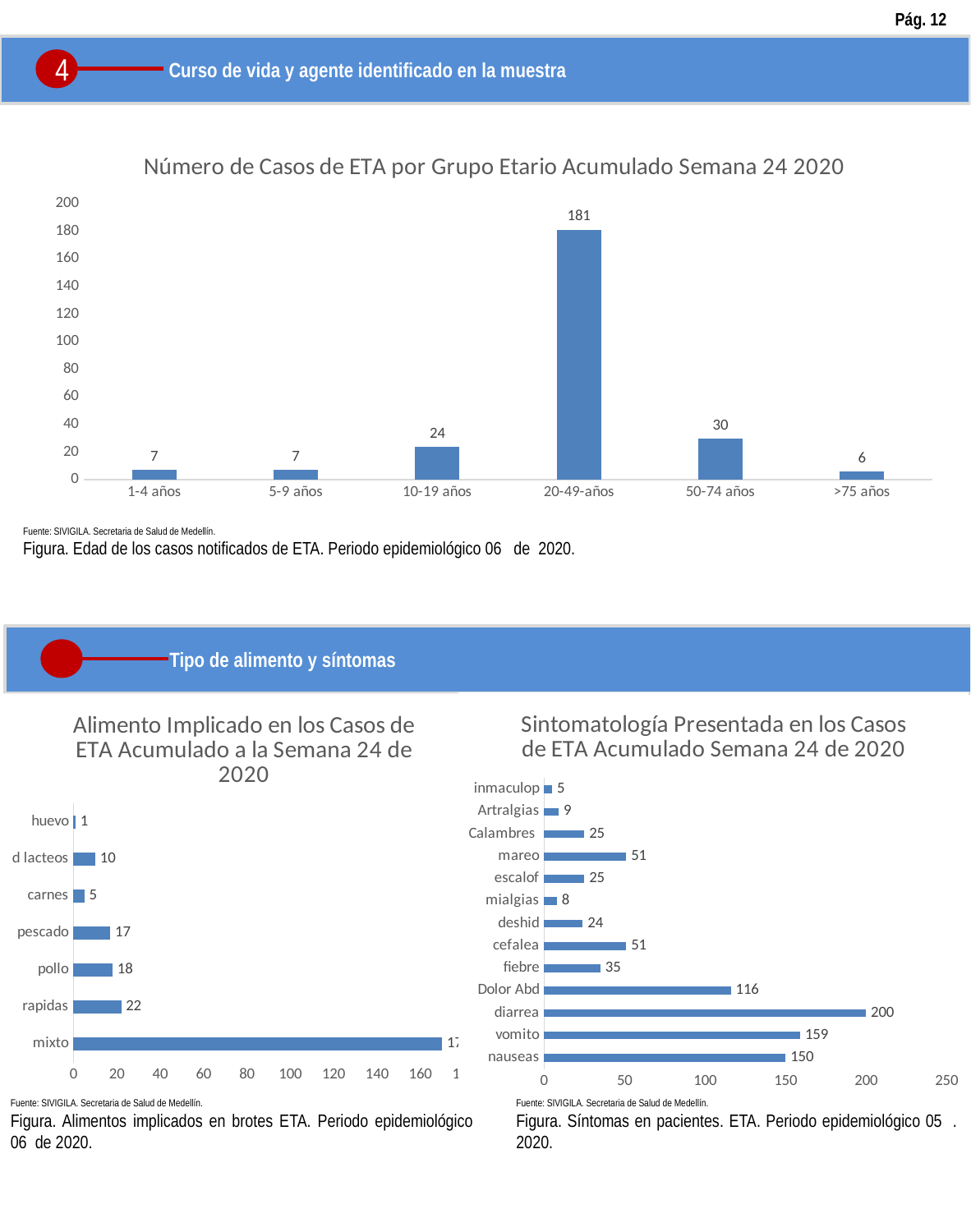
How many symptom categories are shown in the chart 'Sintomatología Presentada en los Casos de ETA Acumulado Semana 24 de 2020'? 13 In the chart 'Número de Casos de ETA por Grupo Etario Acumulado Semana 24 2020', which age group has the lowest value? >75 años In the chart 'Sintomatología Presentada en los Casos de ETA Acumulado Semana 24 de 2020', what is the difference between the values for diarrea and Dolor Abd? 84 In the chart 'Alimento Implicado en los Casos de ETA Acumulado a la Semana 24 de 2020', which category has the highest value? mixto In the chart 'Alimento Implicado en los Casos de ETA Acumulado a la Semana 24 de 2020', is the value for mixto greater or less than 160? greater In the chart 'Alimento Implicado en los Casos de ETA Acumulado a la Semana 24 de 2020', which is larger, the value for rapidas or the value for d lacteos? rapidas In the chart 'Número de Casos de ETA por Grupo Etario Acumulado Semana 24 2020', what is the difference between the values for 50-74 años and 10-19 años? 6 How many age groups are shown in the chart 'Número de Casos de ETA por Grupo Etario Acumulado Semana 24 2020'? 6 In the chart 'Alimento Implicado en los Casos de ETA Acumulado a la Semana 24 de 2020', what is the value for pollo? 18 In the chart 'Sintomatología Presentada en los Casos de ETA Acumulado Semana 24 de 2020', what is the value for vomito? 159 In the chart 'Número de Casos de ETA por Grupo Etario Acumulado Semana 24 2020', what is the value for 20-49-años? 181 What kind of chart is 'Número de Casos de ETA por Grupo Etario Acumulado Semana 24 2020'? bar chart